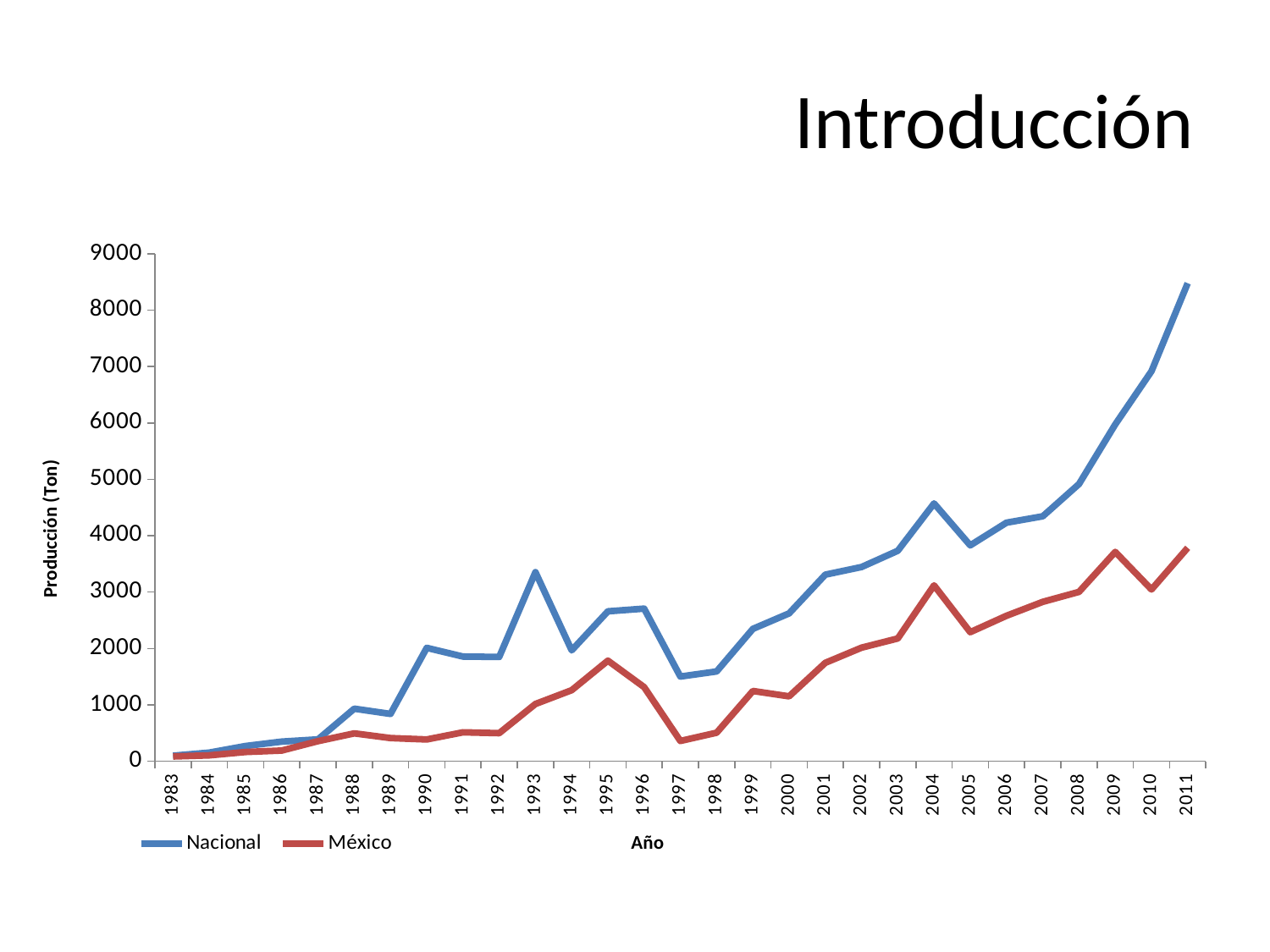
In which year is the México series at its lowest value? 1983 What kind of chart is shown on the slide? line chart Overall, do the values of the Nacional series rise or fall from 1983 to 2011? rise Is the value for Nacional in 2011 greater or less than 8000? greater In which year does the Nacional series reach its highest value? 2011 Which series has the larger value in 2011, Nacional or México? Nacional What is the title of the vertical axis? Producción (Ton) Is the value for México in 1997 greater or less than 1000? less In which year is the Nacional series at its lowest value? 1983 How many years are plotted along the x axis? 29 Is the value for Nacional in 2004 greater or less than 4000? greater How many series does the legend list? 2